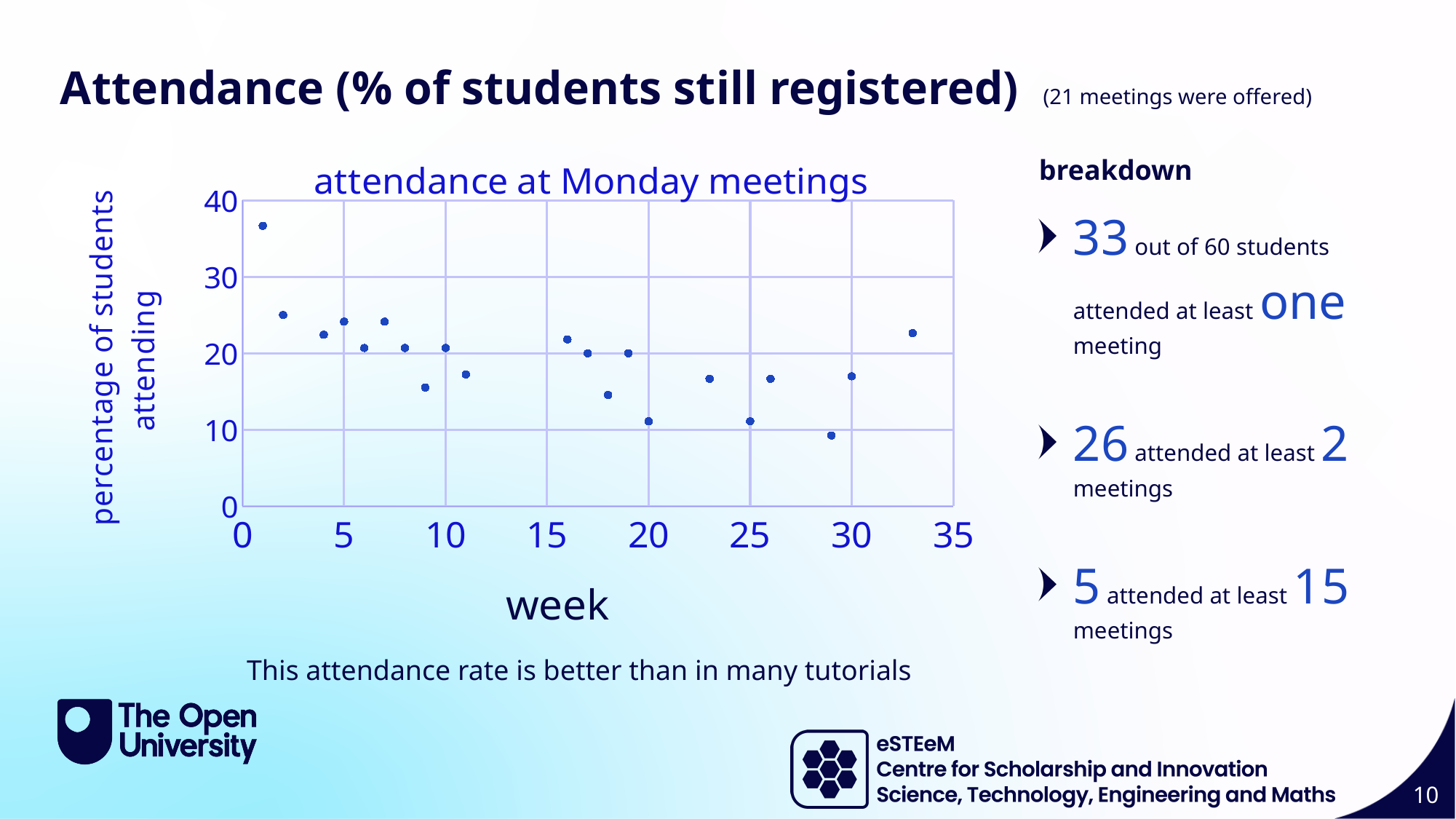
Which week has the lowest percentage of students attending? week 29 Is the percentage of students attending in week 33 greater or less than 20? greater Is the percentage of students attending in week 29 greater or less than 10? less What is the label of the x axis of the chart? week Which has a higher percentage of students attending, week 9 or week 10? week 10 How many data points are plotted on the chart? 21 Is the percentage of students attending in week 1 greater or less than 30? greater What is the title of the chart? attendance at Monday meetings Which week has the highest percentage of students attending? week 1 What kind of chart is shown on the slide? scatter chart Overall, does the percentage of students attending rise or fall as the weeks progress? fall